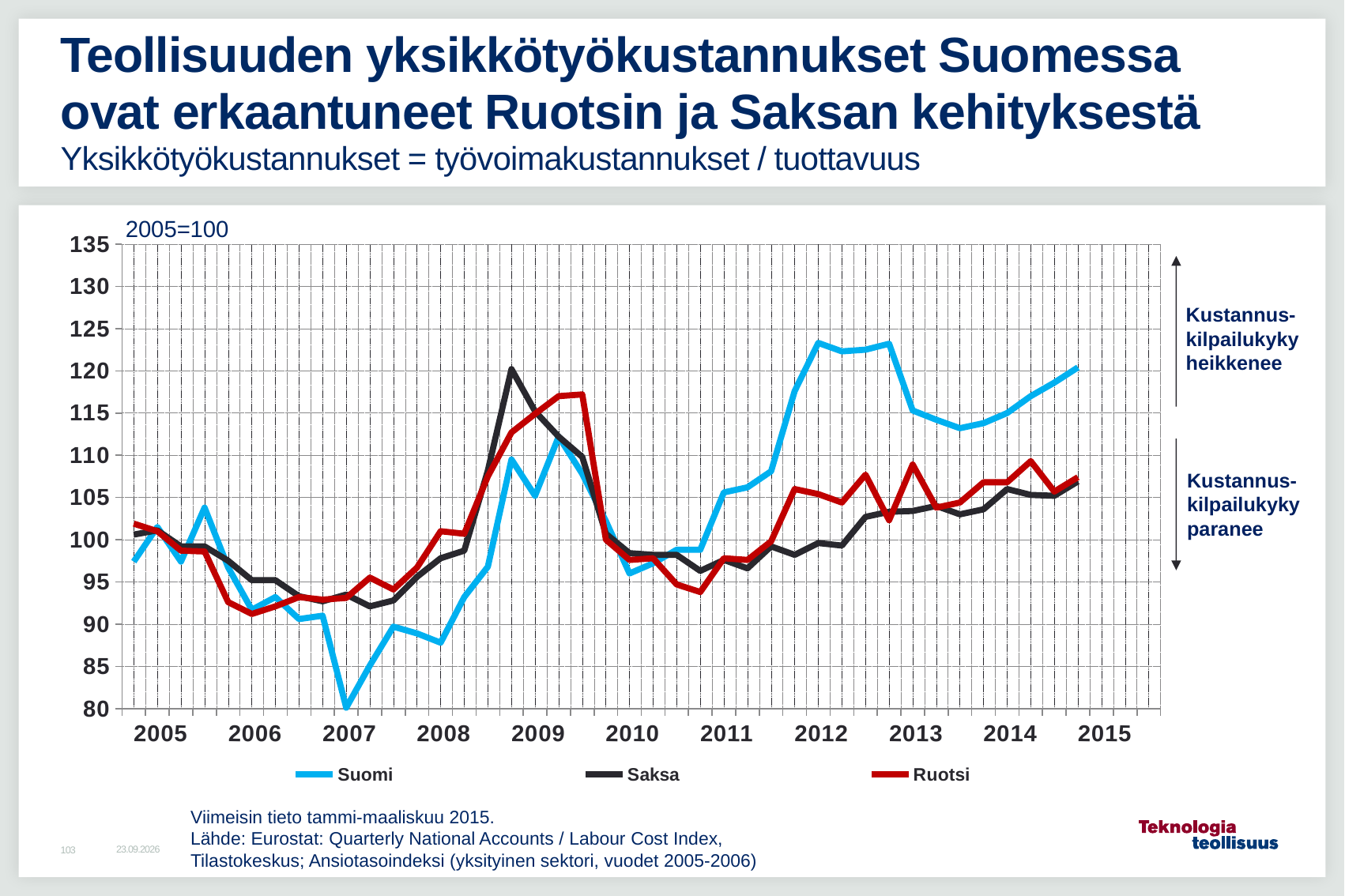
Which series is drawn in red? Ruotsi Is the value for Ruotsi in 2006 greater or less than 95? less What kind of chart is shown on the slide? line chart Which series has the highest value in 2012? Suomi In 2007, which is larger, the value for Saksa or the value for Suomi? Saksa What base year and value is the index set to, as noted above the chart? 2005=100 Which series has the lowest value in 2007? Suomi How many series does the legend list? 3